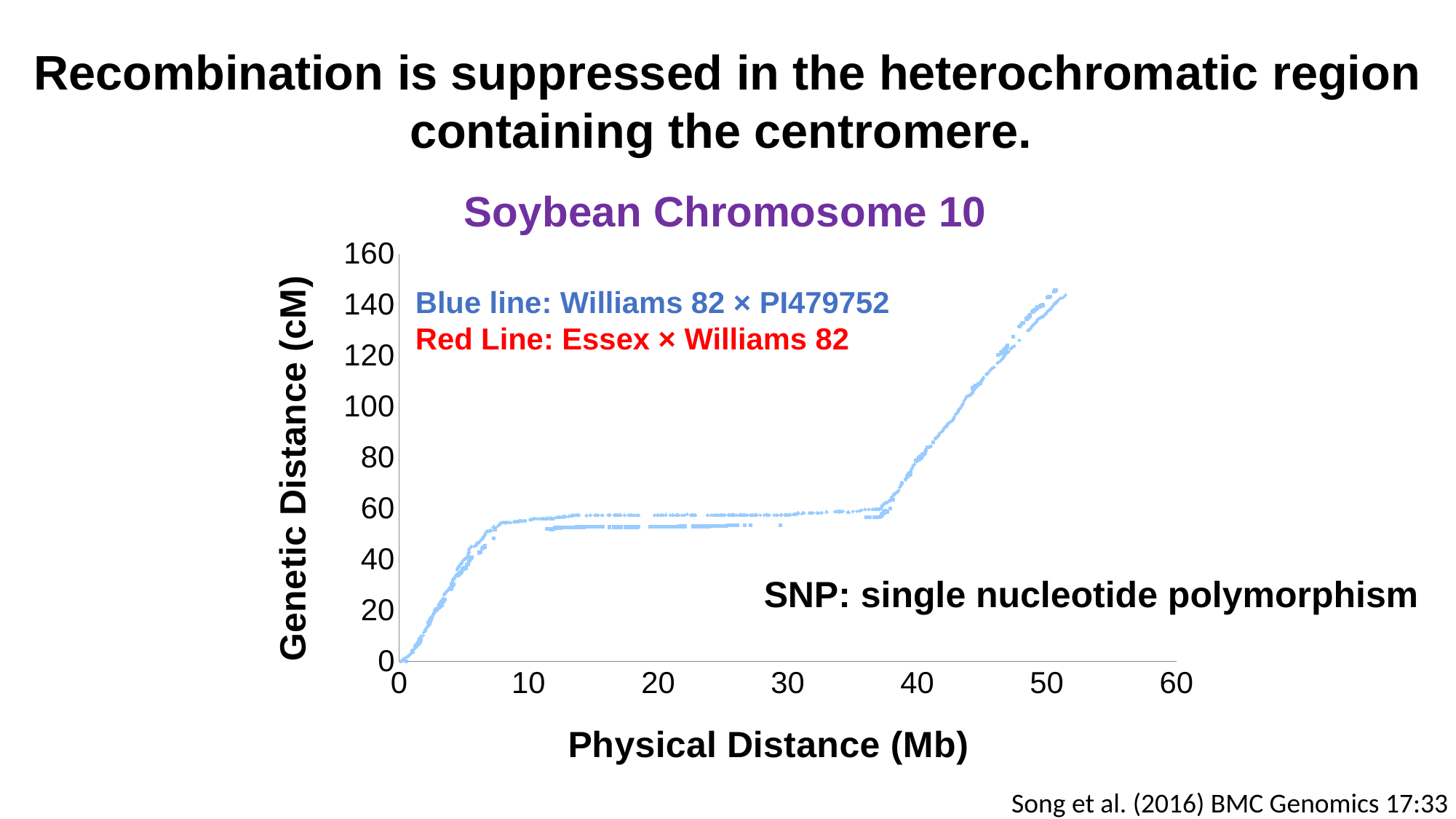
Overall, does genetic distance rise or fall as physical distance increases along the x axis? rise Is the genetic distance at a physical distance of 20 Mb greater or less than 80 cM? less Is the genetic distance at a physical distance of 20 Mb greater or less than 40 cM? greater What is the maximum value shown on the y axis? 160 What is the label of the y axis? Genetic Distance (cM) Which is larger, the genetic distance at 10 Mb or at 45 Mb? 45 Mb Is the genetic distance at a physical distance of 50 Mb greater or less than 120 cM? greater What is the title of the chart? Soybean Chromosome 10 Between physical distances of 10 Mb and 35 Mb, does the genetic distance rise steeply or stay roughly flat? stay roughly flat